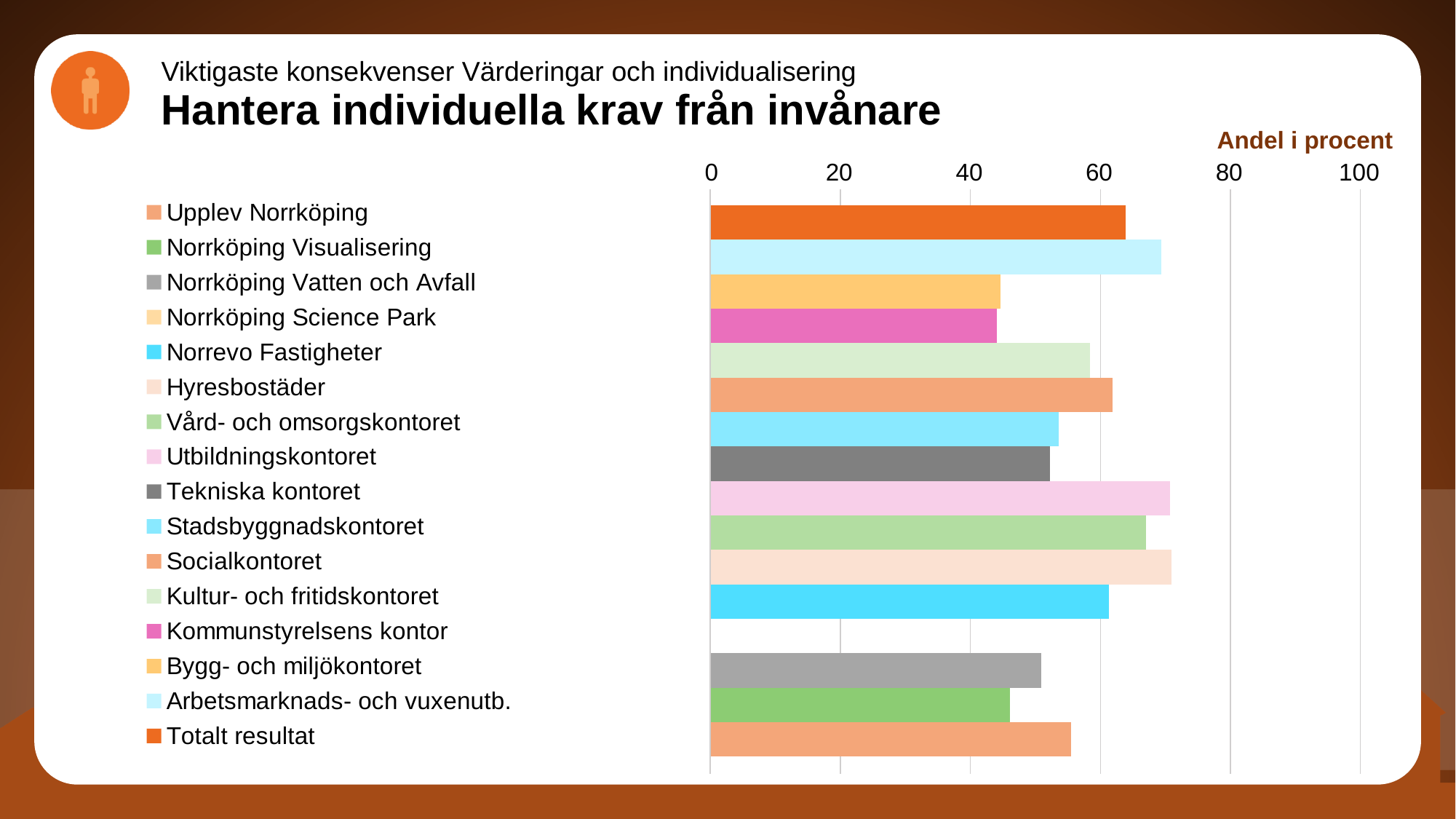
Is the value for Utbildningskontoret greater or less than 60? greater Which has the larger value, Arbetsmarknads- och vuxenutb. or Bygg- och miljökontoret? Arbetsmarknads- och vuxenutb. Is the value for Tekniska kontoret greater or less than 60? less What is the label shown above the horizontal axis of the chart? Andel i procent What kind of chart is shown on the slide? bar chart Is the value for Kommunstyrelsens kontor greater or less than 60? less How many categories does the chart legend list? 16 What is the main title of the slide above the chart? Hantera individuella krav från invånare Which has the larger value, Utbildningskontoret or Tekniska kontoret? Utbildningskontoret